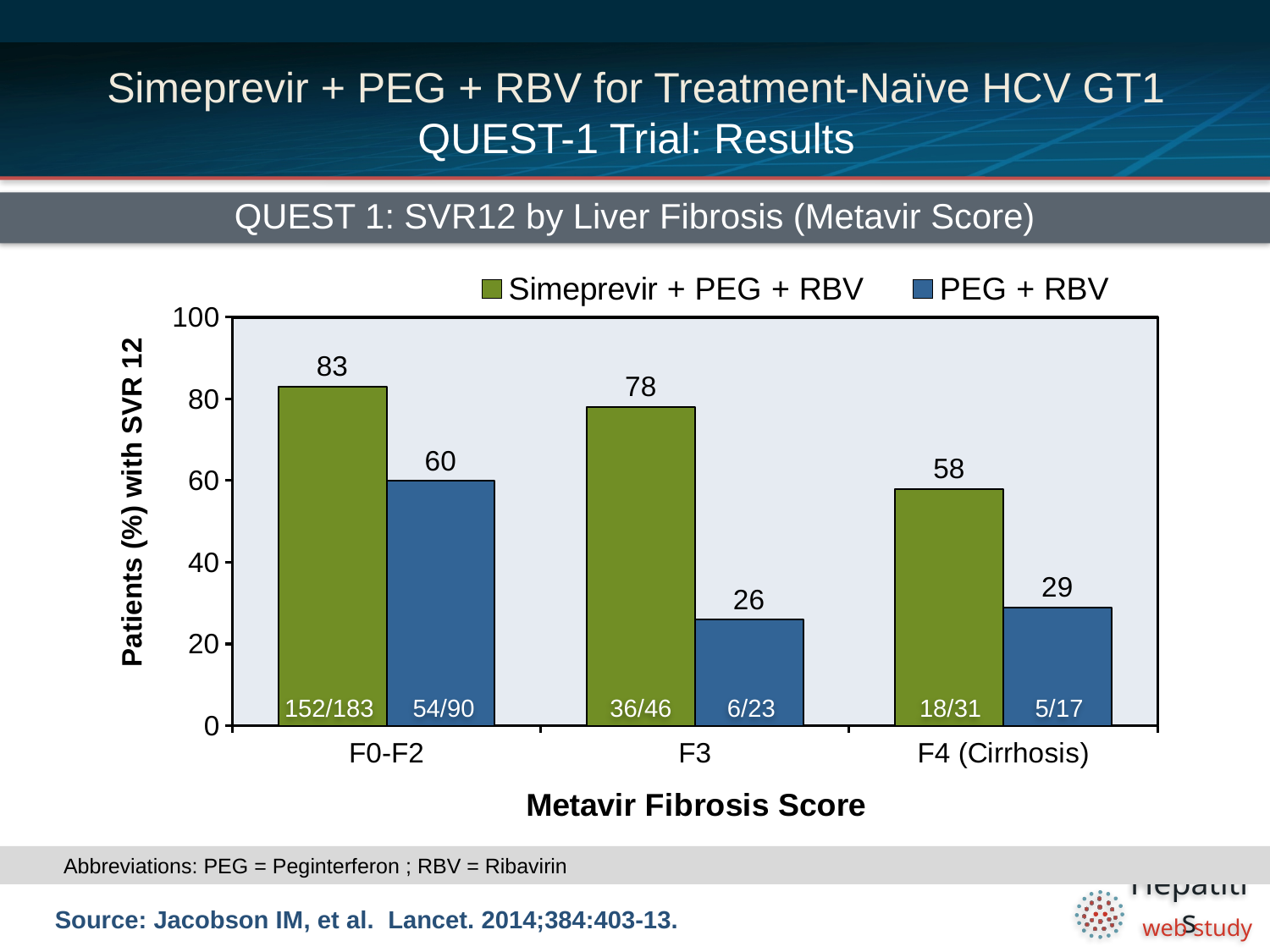
What is the difference in SVR12 rate between Simeprevir + PEG + RBV and PEG + RBV in the F3 group? 52 How many series does the legend list? 2 How many Metavir fibrosis score groups are shown on the x axis? 3 Which has a higher SVR12 rate in the F4 (Cirrhosis) group: Simeprevir + PEG + RBV or PEG + RBV? Simeprevir + PEG + RBV Which Metavir fibrosis score group has the lowest SVR12 rate for PEG + RBV? F3 Which Metavir fibrosis score group has the highest SVR12 rate for Simeprevir + PEG + RBV? F0-F2 What is the SVR12 rate for PEG + RBV in the F3 group? 26 What is the patient fraction shown inside the Simeprevir + PEG + RBV bar for the F4 (Cirrhosis) group? 18/31 What is the SVR12 rate for PEG + RBV in the F4 (Cirrhosis) group? 29 What is the SVR12 rate for Simeprevir + PEG + RBV in the F0-F2 group? 83 What kind of chart is shown on the slide? Bar chart Is the SVR12 rate for Simeprevir + PEG + RBV in the F3 group greater or less than 60? greater